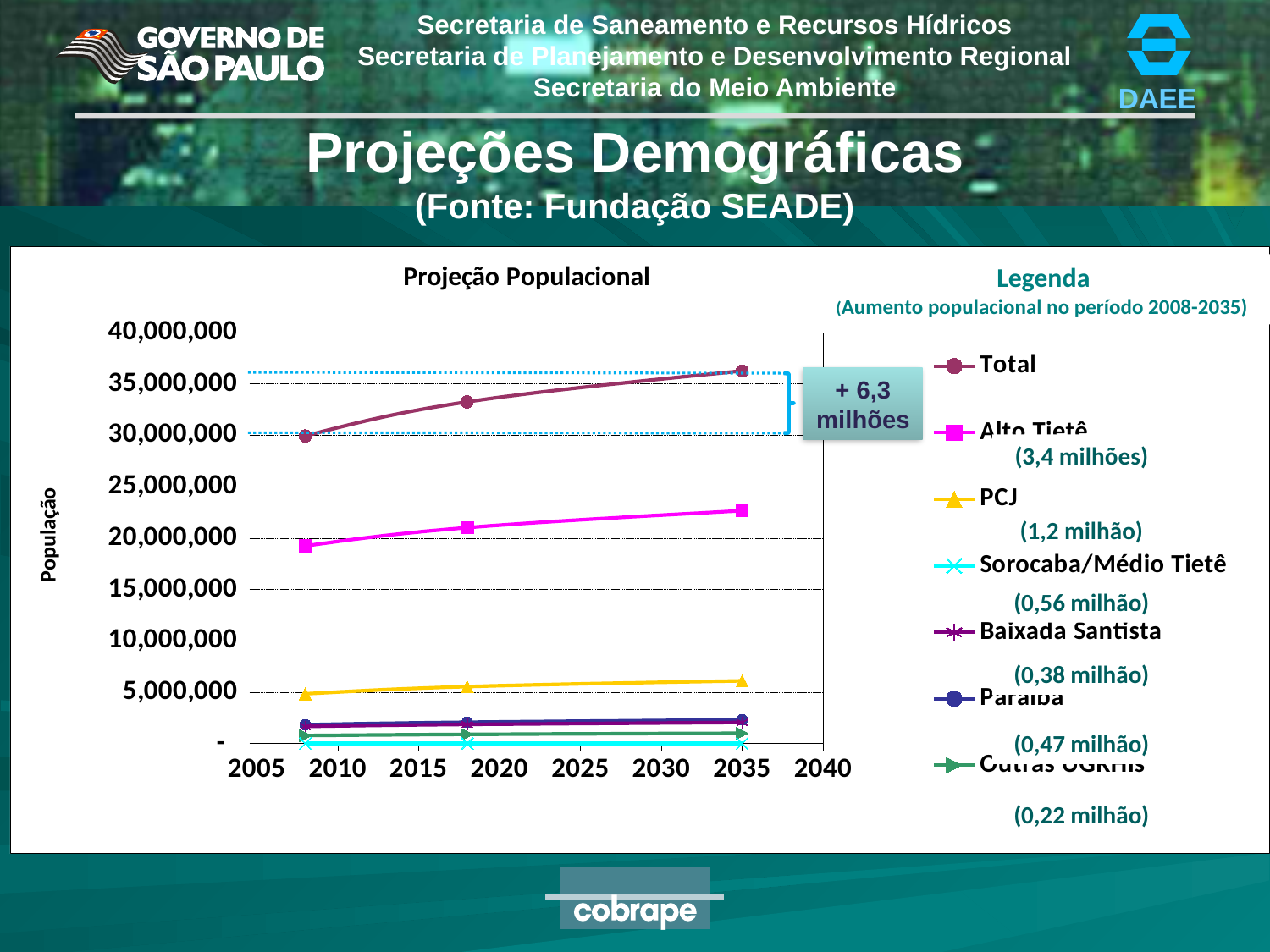
Is the value of the PCJ series in 2035 greater or less than 5,000,000? greater Is the value of the Total series in 2035 greater or less than 35,000,000? greater Is the value of the Alto Tietê series in 2035 greater or less than 20,000,000? greater Which series has the lowest values in the "Projeção Populacional" chart? Sorocaba/Médio Tietê What population increase is annotated next to the Total series in the "Projeção Populacional" chart? + 6,3 milhões How many data points are plotted for the Total series in the "Projeção Populacional" chart? 3 Which series has the highest values in the "Projeção Populacional" chart? Total Does the Total series rise or fall from 2008 to 2035 in the "Projeção Populacional" chart? Rises What kind of chart is shown under the title "Projeção Populacional"? Line chart How many series does the legend of the "Projeção Populacional" chart list? 7 What is the label on the vertical axis of the "Projeção Populacional" chart? População In 2035, which is larger in the "Projeção Populacional" chart: Alto Tietê or PCJ? Alto Tietê